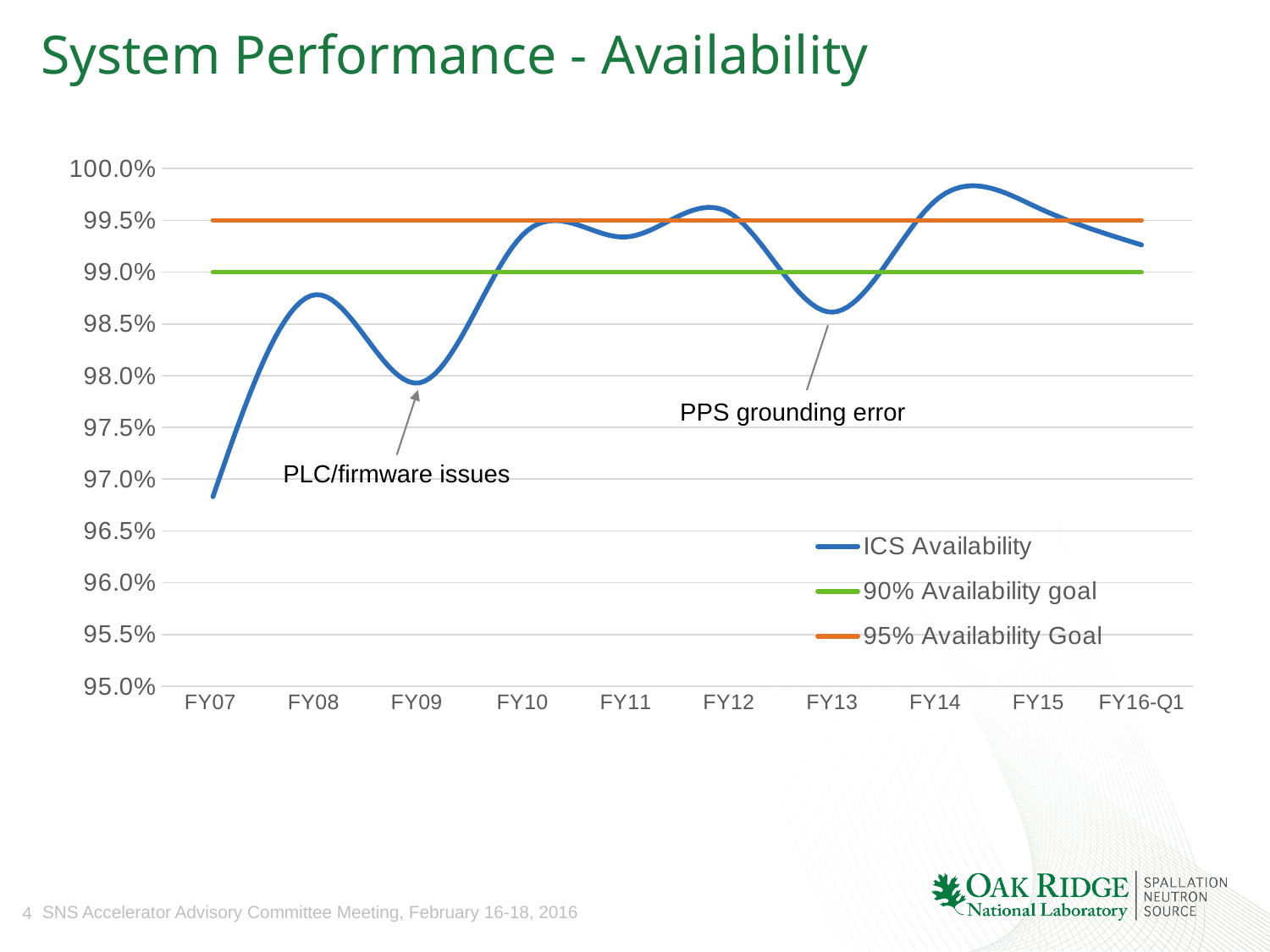
In which fiscal year is ICS Availability lowest? FY07 In which fiscal year is ICS Availability highest? FY14 Is the ICS Availability value for FY13 greater or less than 99.0%? less How many fiscal-year categories are shown on the x axis? 10 Is the ICS Availability value for FY14 greater or less than 99.5%? greater At what value does the 95% Availability Goal line sit on the y axis? 99.5% What annotation labels the dip in ICS Availability at FY13? PPS grounding error Is the ICS Availability value for FY07 greater or less than 97.0%? less How many series does the legend list? 3 Which fiscal year has higher ICS Availability, FY08 or FY09? FY08 What kind of chart is shown on the slide? line chart At what value does the 90% Availability goal line sit on the y axis? 99.0%